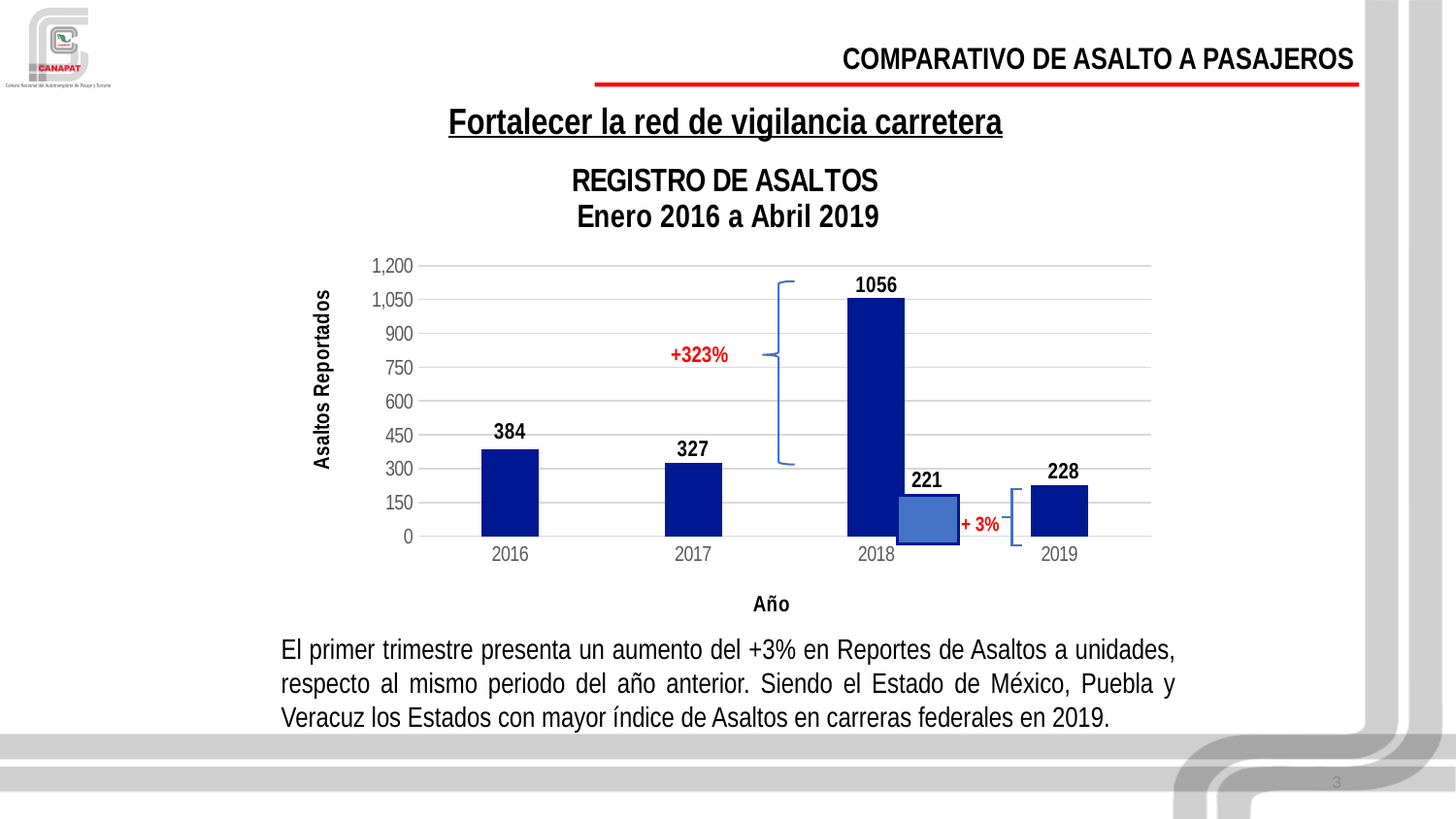
What is the value for 2016 in the chart? 384 What is the label of the y axis? Asaltos Reportados Which is larger, the value for 2016 or the value for 2019? 2016 What is the value for 2019 in the chart? 228 What is the difference between the 2016 value and the 2017 value? 57 What kind of chart is shown on the slide? Bar chart Which year has the highest number of reported assaults? 2018 What is the value for 2017 in the chart? 327 What is the difference between the 2019 value and the lighter 2018 bar labelled 221? 7 Is the value for 2018 (tallest bar) greater or less than 900? greater What is the value of the tallest bar for 2018? 1056 How many years are shown on the x axis? 4